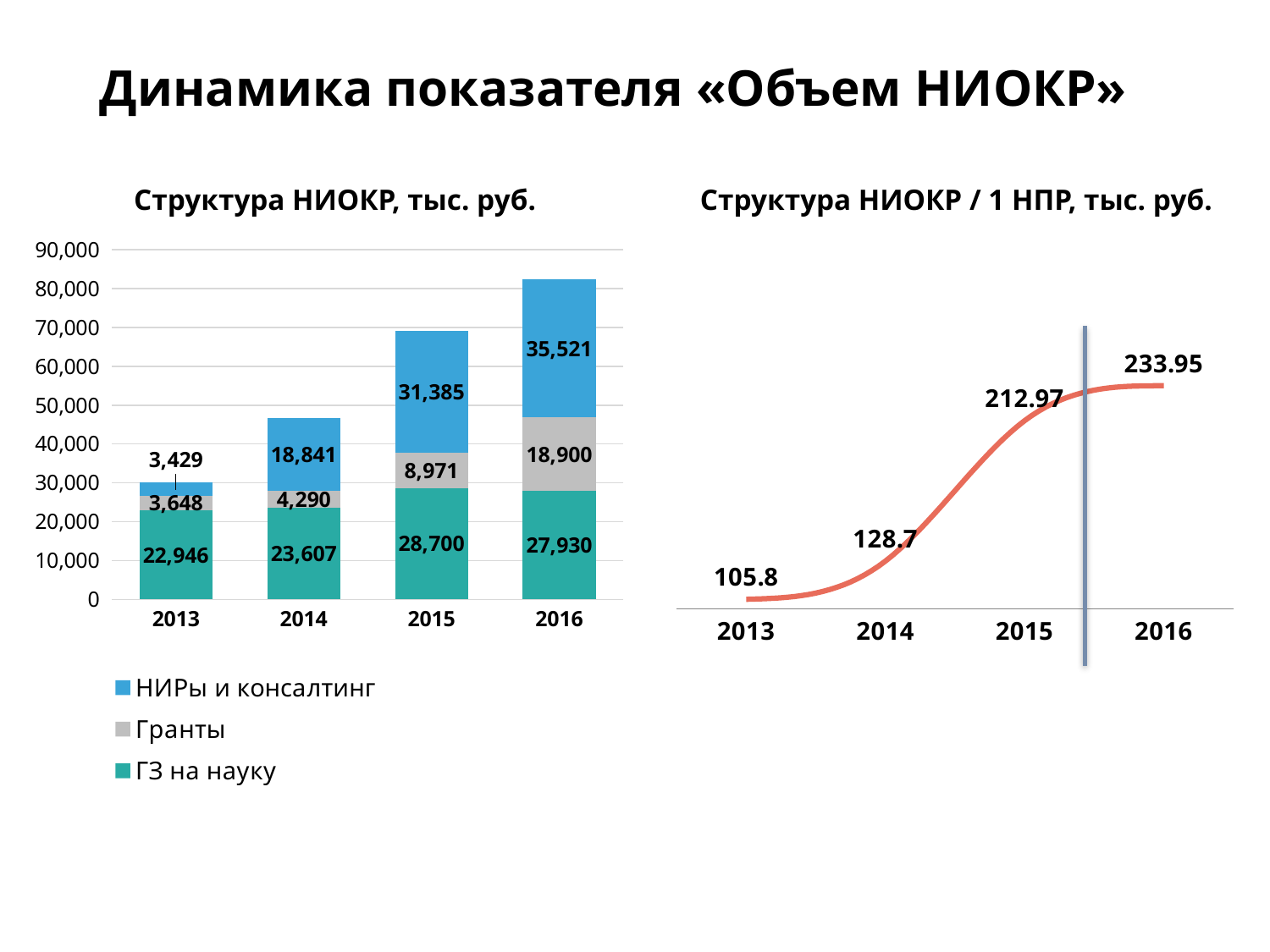
In the right chart (Структура НИОКР / 1 НПР, тыс. руб.), what is the difference between the 2016 and 2013 values? 128.15 What kind of chart is the right chart (Структура НИОКР / 1 НПР, тыс. руб.)? Line chart In the left chart (Структура НИОКР, тыс. руб.), what is the value of ГЗ на науку for 2015? 28,700 In the left chart (Структура НИОКР, тыс. руб.), which year has the lowest value for НИРы и консалтинг? 2013 In the left chart (Структура НИОКР, тыс. руб.), what is the total of the stacked bar for 2013? 30,023 In the right chart (Структура НИОКР / 1 НПР, тыс. руб.), which year has the highest value? 2016 In the left chart (Структура НИОКР, тыс. руб.), which is larger in 2016: ГЗ на науку or Гранты? ГЗ на науку How many series does the legend of the left chart (Структура НИОКР, тыс. руб.) list? 3 In the left chart (Структура НИОКР, тыс. руб.), what is the value of Гранты for 2016? 18,900 In the right chart (Структура НИОКР / 1 НПР, тыс. руб.), do the values rise or fall from 2013 to 2016? Rise In the right chart (Структура НИОКР / 1 НПР, тыс. руб.), what is the value for 2015? 212.97 In the left chart (Структура НИОКР, тыс. руб.), by how much did НИРы и консалтинг increase from 2015 to 2016? 4,136